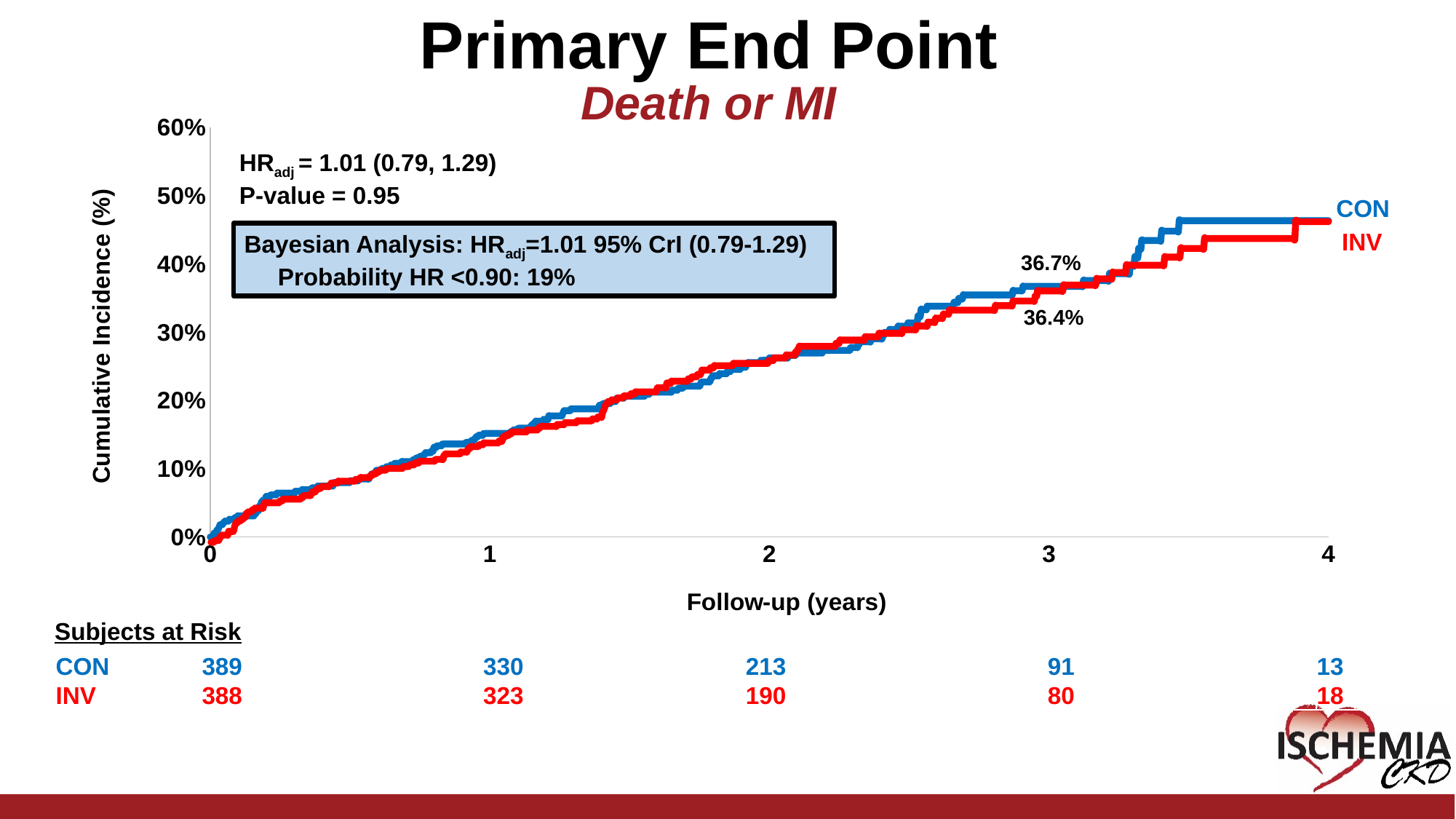
What is the difference between the labelled 3-year cumulative incidence values for CON and INV? 0.3% How many INV subjects were at risk at 2 years? 190 How many CON subjects were at risk at 0 years? 389 How many series (groups) are plotted on the chart? 2 What is the label of the y-axis? Cumulative Incidence (%) Is the cumulative incidence for INV at 1 year greater or less than 20%? less Do the cumulative incidence curves rise or fall as follow-up time increases? rise What cumulative incidence is labelled for the INV group at 3 years of follow-up? 36.4% Is the cumulative incidence for CON at 4 years greater or less than 40%? greater What cumulative incidence is labelled for the CON group at 3 years of follow-up? 36.7% What kind of chart is shown on the slide? line chart At 3 years, which group has the higher labelled cumulative incidence, CON or INV? CON